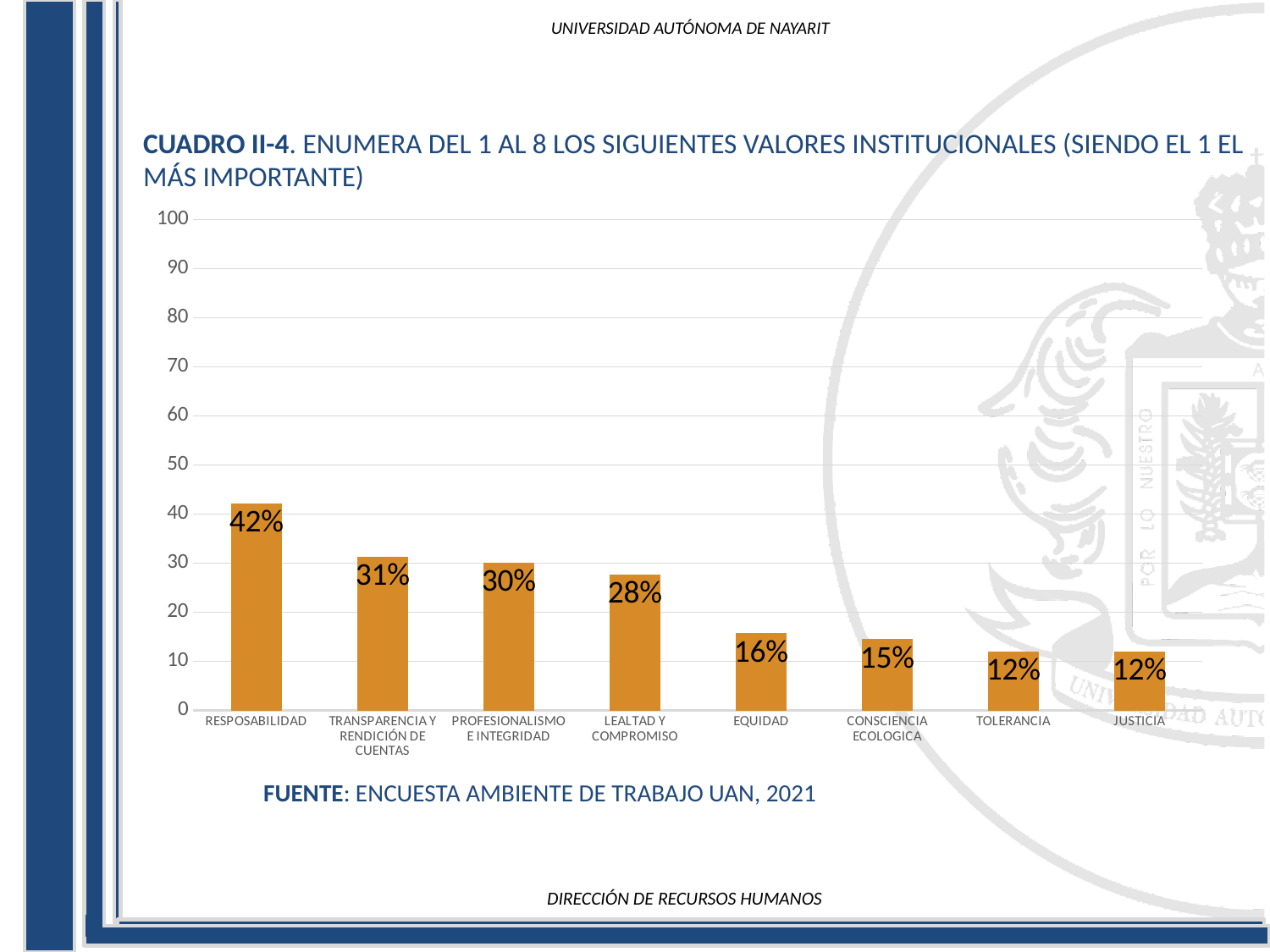
What is the difference between the values for RESPOSABILIDAD and TRANSPARENCIA Y RENDICIÓN DE CUENTAS? 11% What is the value for CONSCIENCIA ECOLOGICA? 15% How many categories are shown on the x axis? 8 Is the value for TRANSPARENCIA Y RENDICIÓN DE CUENTAS greater or less than 20? greater What is the difference between the values for LEALTAD Y COMPROMISO and EQUIDAD? 12% Which category has the highest value? RESPOSABILIDAD Which is larger, the value for PROFESIONALISMO E INTEGRIDAD or the value for LEALTAD Y COMPROMISO? PROFESIONALISMO E INTEGRIDAD What is the value for RESPOSABILIDAD? 42% Do the values generally rise or fall from left to right along the x axis? fall What source is cited below the chart? ENCUESTA AMBIENTE DE TRABAJO UAN, 2021 What kind of chart is shown on the slide? bar chart What is the value for EQUIDAD? 16%